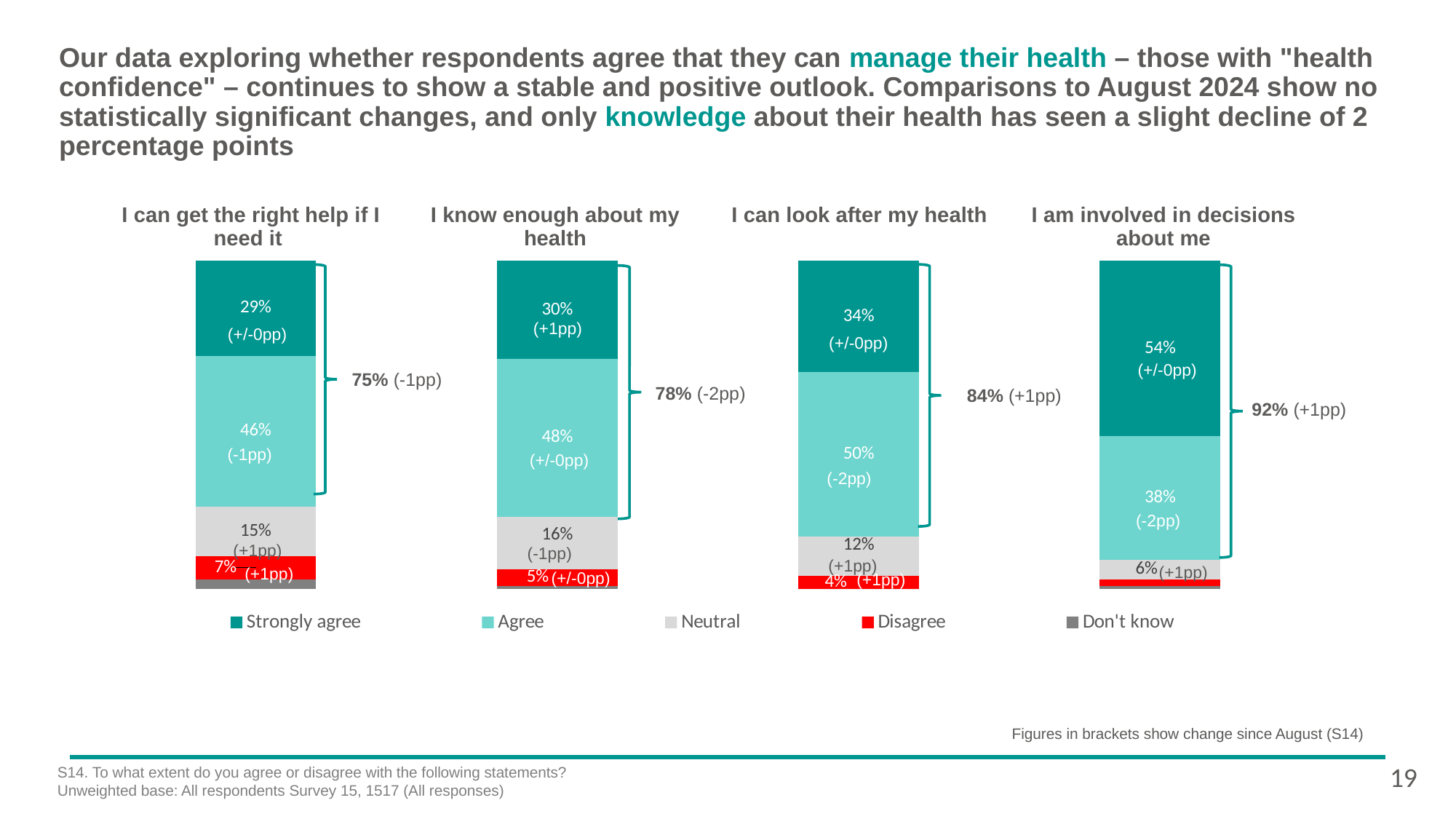
Which of the four statements has the lowest combined strongly agree and agree percentage? I can get the right help if I need it In the chart titled "I can get the right help if I need it", what percentage of respondents strongly agree? 29% In the chart titled "I know enough about my health", what percentage of respondents agree? 48% How many series does the legend list? 5 Is the strongly agree percentage higher for "I can look after my health" or for "I know enough about my health"? I can look after my health In the chart titled "I am involved in decisions about me", what is the combined percentage of respondents who strongly agree or agree? 92% What kind of chart is used on the slide? Stacked bar chart Which of the four statements has the highest combined strongly agree and agree percentage? I am involved in decisions about me In the chart titled "I am involved in decisions about me", what is the difference between the strongly agree and agree percentages? 16% In the chart titled "I can look after my health", what percentage of respondents are neutral? 12% What colour represents the "Disagree" series in the legend? Red How many statements are shown as stacked bars on the slide? 4